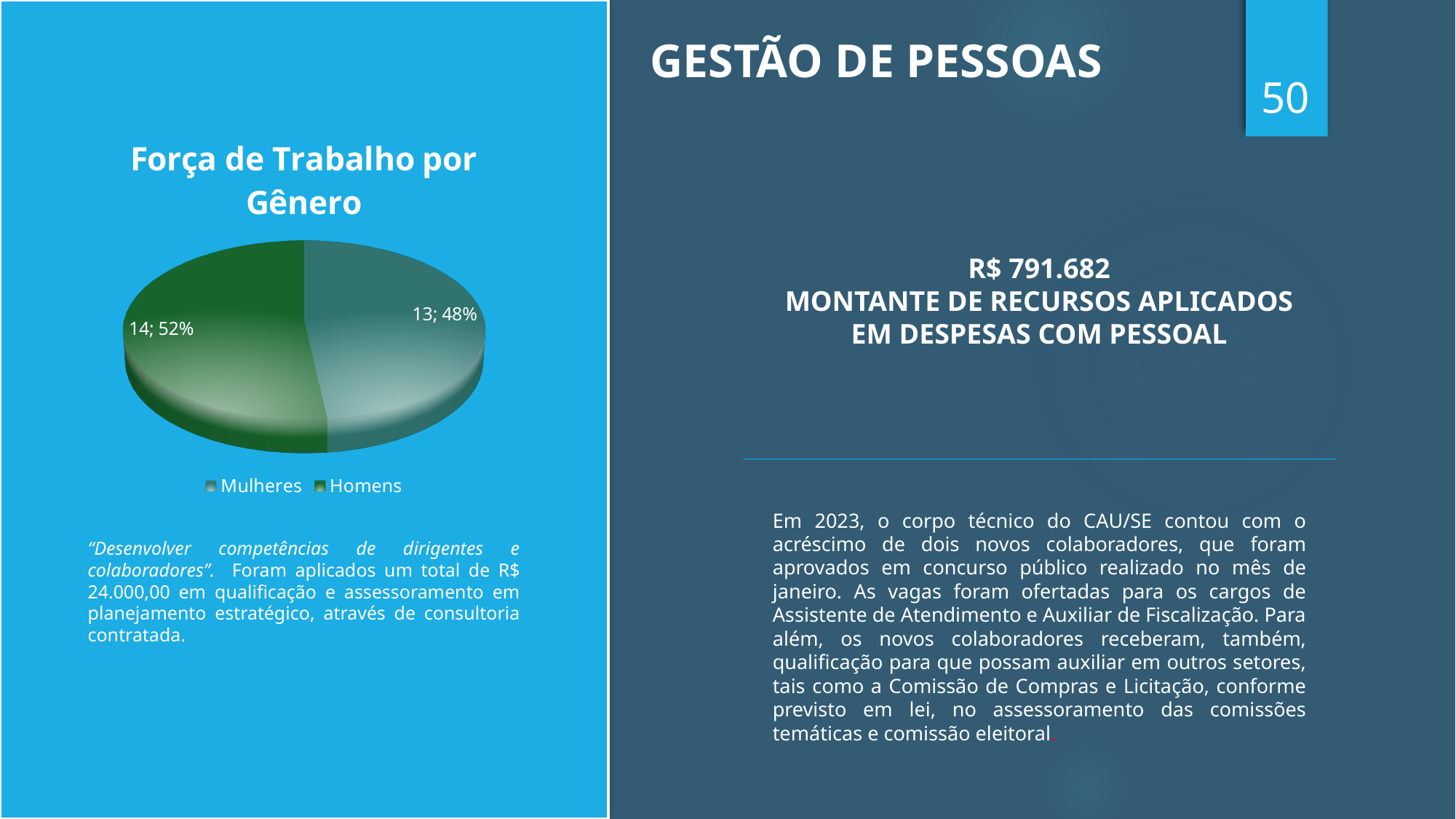
How many entries does the chart legend list? 2 What kind of chart is shown on the slide? pie chart What share of the pie does Homens represent? 52% What is the total of the two slice values in the pie chart? 27 Which category has the larger slice, Mulheres or Homens? Homens How many slices does the pie chart have? 2 Which category has the smallest slice? Mulheres What is the title of the chart? Força de Trabalho por Gênero What share of the pie does Mulheres represent? 48% What is the value shown for Homens? 14 What is the difference between the values for Homens and Mulheres? 1 What is the value shown for Mulheres? 13